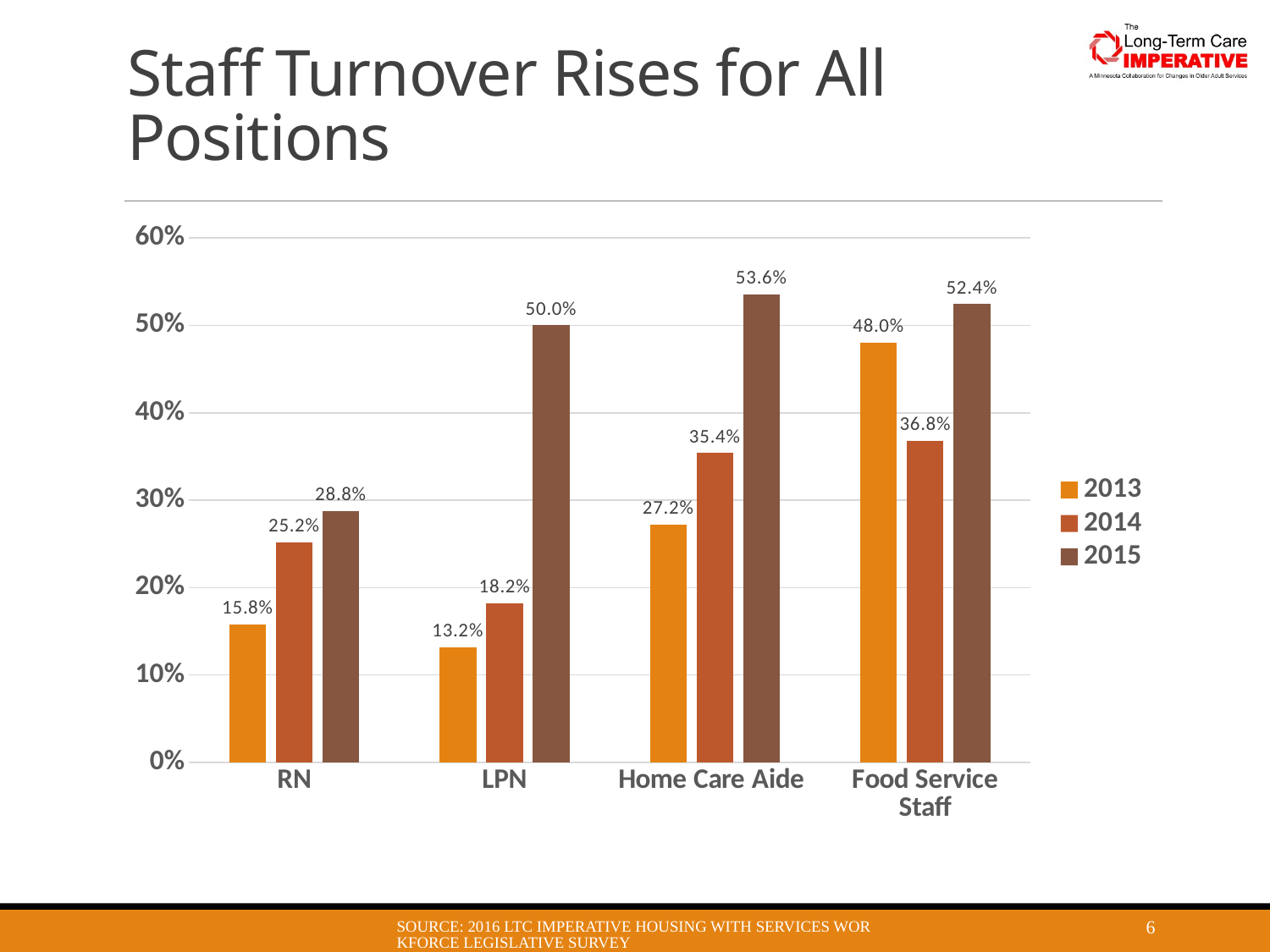
What was the staff turnover rate for Home Care Aide in 2014? 35.4% What was the staff turnover rate for RN in 2015? 28.8% What kind of chart is shown on the slide? Bar chart What was the staff turnover rate for LPN in 2013? 13.2% Which position had the highest turnover rate in 2015? Home Care Aide Which is larger: the 2014 turnover rate for Food Service Staff or the 2014 turnover rate for Home Care Aide? Food Service Staff Is the 2013 turnover rate for Food Service Staff greater or less than 40%? greater Which position had the lowest turnover rate in 2013? LPN How many series does the legend list? 3 How many positions are shown on the x axis? 4 What is the difference between the 2015 and 2013 turnover rates for LPN? 36.8% Which year does the legend associate with the darkest brown bars? 2015